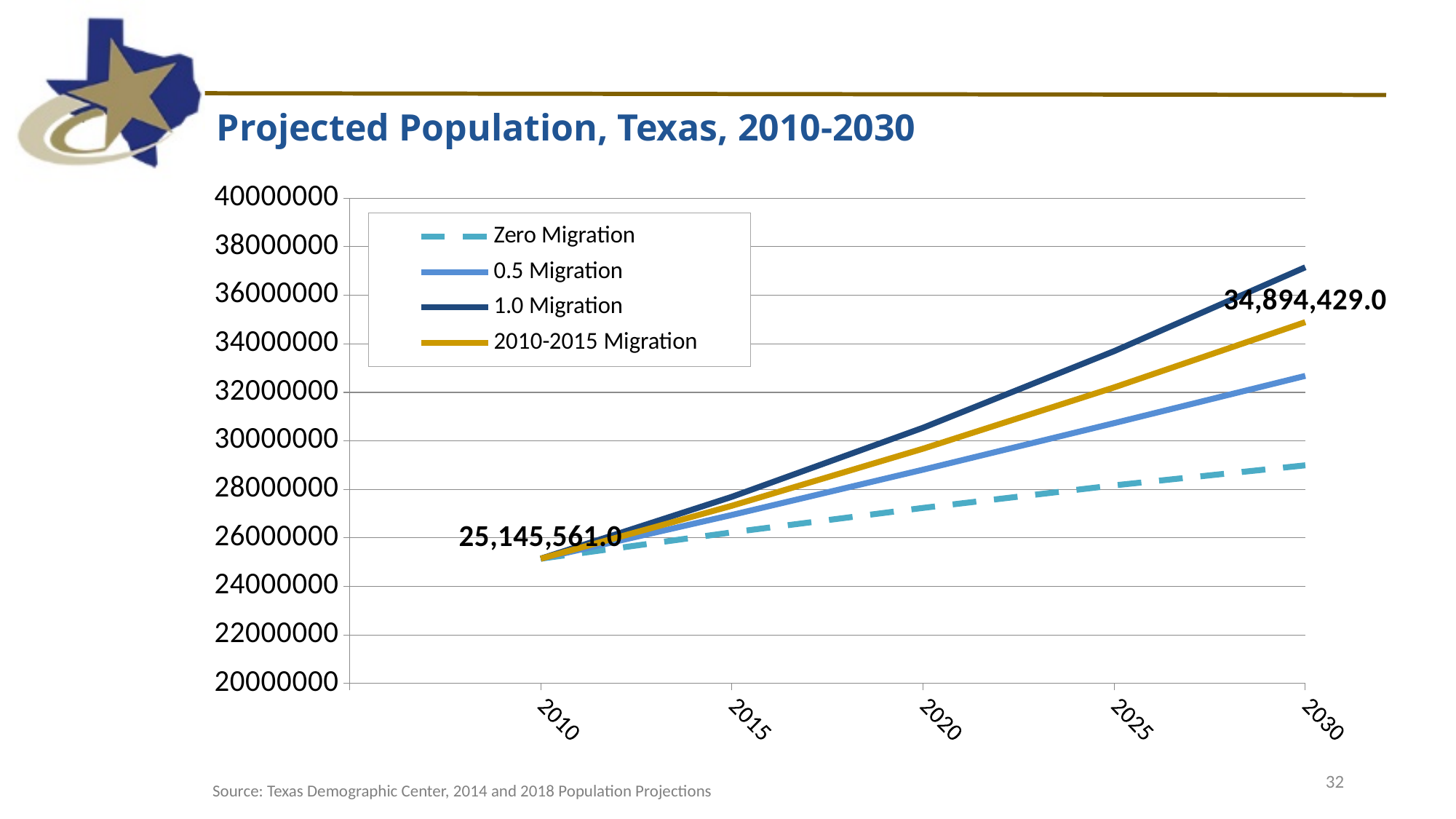
Do the projected population values rise or fall from 2010 to 2030? rise Which series has the highest value in 2030? 1.0 Migration What is the labelled value for the 2010-2015 Migration series in 2030? 34,894,429.0 What kind of chart is shown on the slide? line chart In 2030, which is larger: the 1.0 Migration value or the 0.5 Migration value? 1.0 Migration How many series does the legend list? 4 What is the difference between the labelled 2030 value (34,894,429.0) and the labelled 2010 value (25,145,561.0)? 9,748,868.0 What is the labelled population value at 2010? 25,145,561.0 Which series has the lowest value in 2030? Zero Migration Is the 1.0 Migration value in 2030 greater or less than 36000000? greater Is the Zero Migration value in 2030 greater or less than 30000000? less How many years are labelled on the x axis? 5